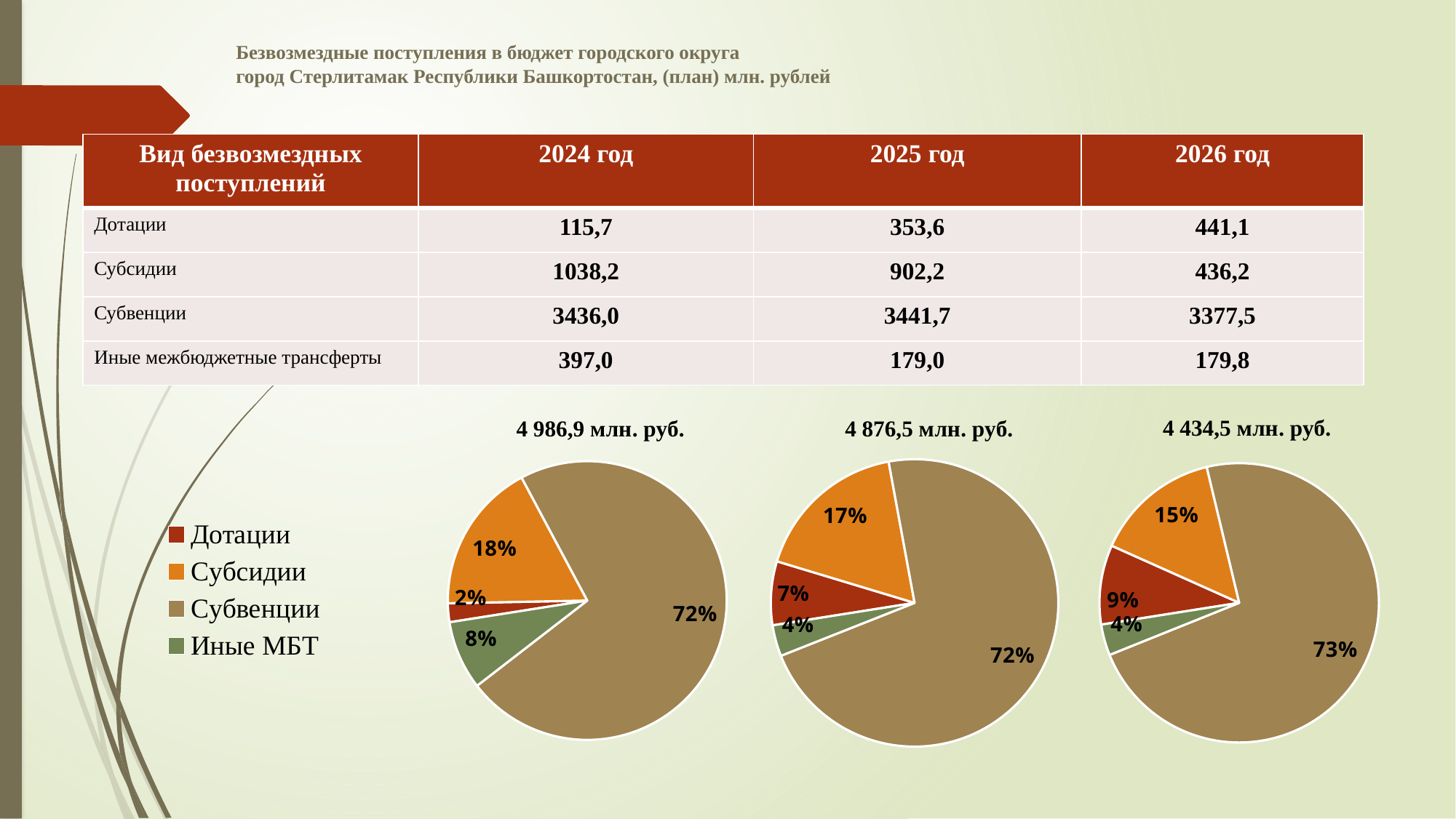
In the left pie chart (4 986,9 млн. руб.), which category has the smallest slice? Дотации In the right pie chart (4 434,5 млн. руб.), which category has the largest slice? Субвенции In the right pie chart (4 434,5 млн. руб.), what share is labelled for Дотации? 9% In the left pie chart (4 986,9 млн. руб.), what share is labelled for Дотации? 2% How many pie charts are on the slide? 3 In the middle pie chart (4 876,5 млн. руб.), what is the difference in percentage points between the Субсидии slice and the Дотации slice? 10 In the middle pie chart (4 876,5 млн. руб.), what share is labelled for Иные МБТ? 4% What kind of charts are shown on the slide? Pie charts What is the title shown above the right pie chart? 4 434,5 млн. руб. How many entries does the legend list for the pie charts? 4